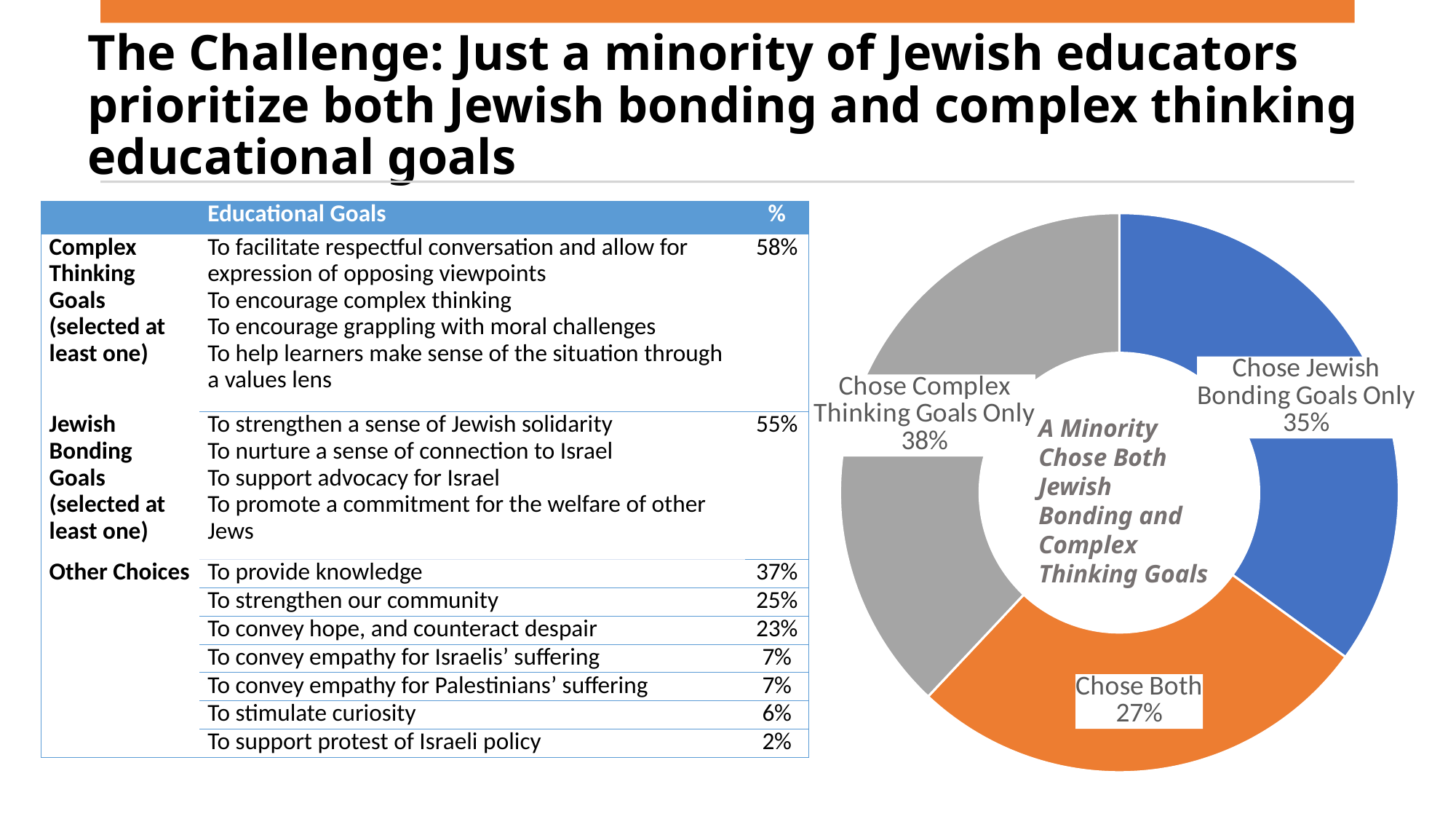
What kind of chart is shown on the right of the slide? Doughnut (pie) chart Which slice of the doughnut chart is the largest? Chose Complex Thinking Goals Only Which slice of the doughnut chart is the smallest? Chose Both What percentage of educators chose Complex Thinking Goals Only according to the chart? 38% What share of the doughnut chart is labelled "Chose Both"? 27% Which is larger in the chart: "Chose Jewish Bonding Goals Only" or "Chose Both"? Chose Jewish Bonding Goals Only What is the difference in percentage points between "Chose Complex Thinking Goals Only" and "Chose Both"? 11 What text appears in the centre of the doughnut chart? A Minority Chose Both Jewish Bonding and Complex Thinking Goals How many slices does the doughnut chart have? 3 What is the difference in percentage points between "Chose Jewish Bonding Goals Only" and "Chose Both"? 8 What percentage of educators chose Jewish Bonding Goals Only according to the chart? 35% What colour is the "Chose Both" slice in the doughnut chart? Orange